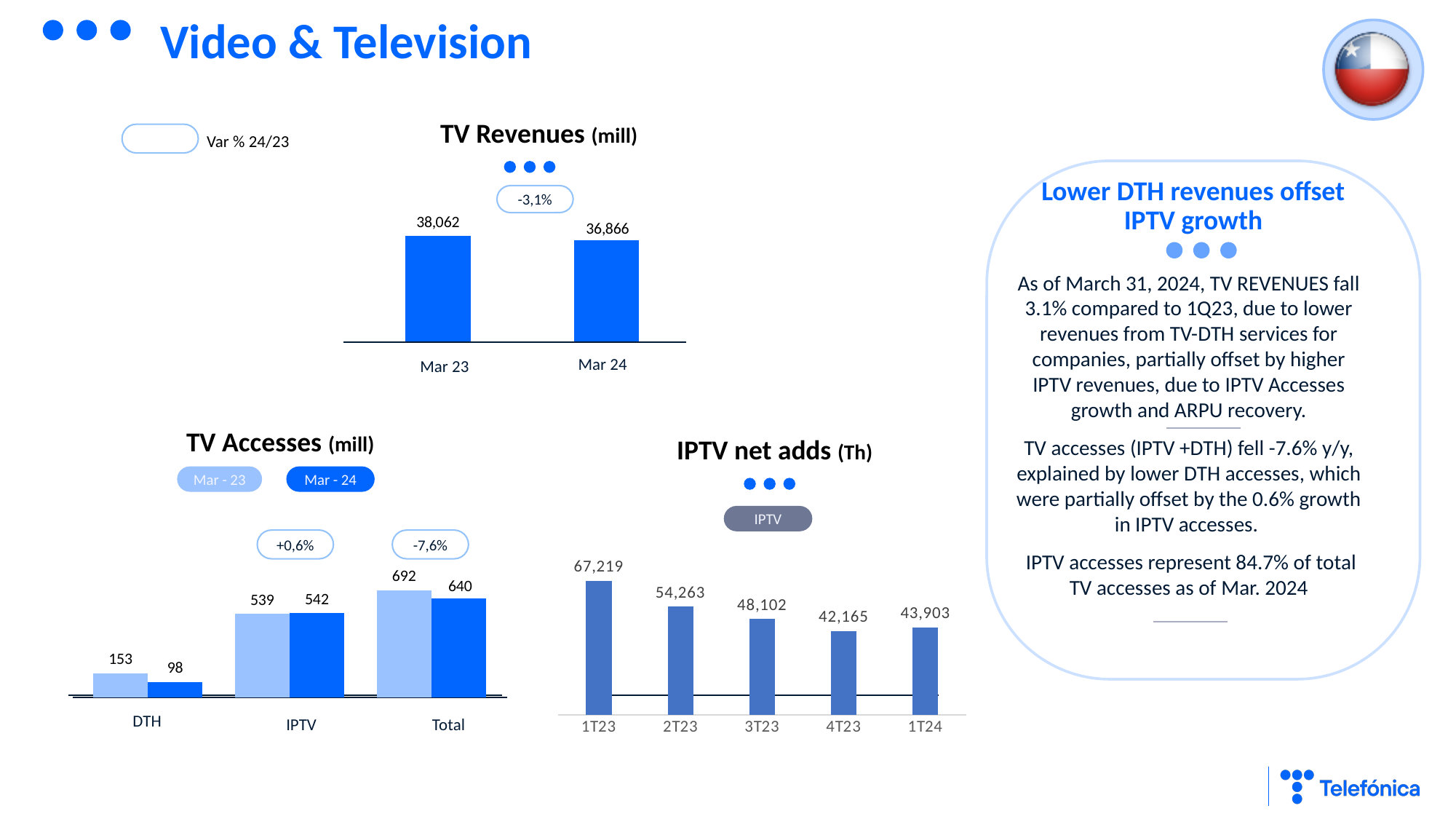
In the TV Accesses (mill) chart, what is the difference between the Mar - 23 and Mar - 24 values for Total? 52 In the IPTV net adds (Th) chart, what is the value for 3T23? 48,102 In the TV Accesses (mill) chart, how many series does the legend list? 2 In the TV Revenues (mill) chart, which period has the higher value, Mar 23 or Mar 24? Mar 23 What kind of chart is the IPTV net adds (Th) chart? Bar chart In the TV Accesses (mill) chart, which category has the lowest Mar - 24 value? DTH In the TV Accesses (mill) chart, what is the Mar - 23 value for IPTV? 539 In the TV Revenues (mill) chart, what is the difference between Mar 23 and Mar 24? 1,196 In the TV Revenues (mill) chart, what is the value for Mar 24? 36,866 In the IPTV net adds (Th) chart, how many quarters are plotted? 5 In the IPTV net adds (Th) chart, which quarter has the highest value? 1T23 In the TV Accesses (mill) chart, what is the Mar - 24 value for DTH? 98